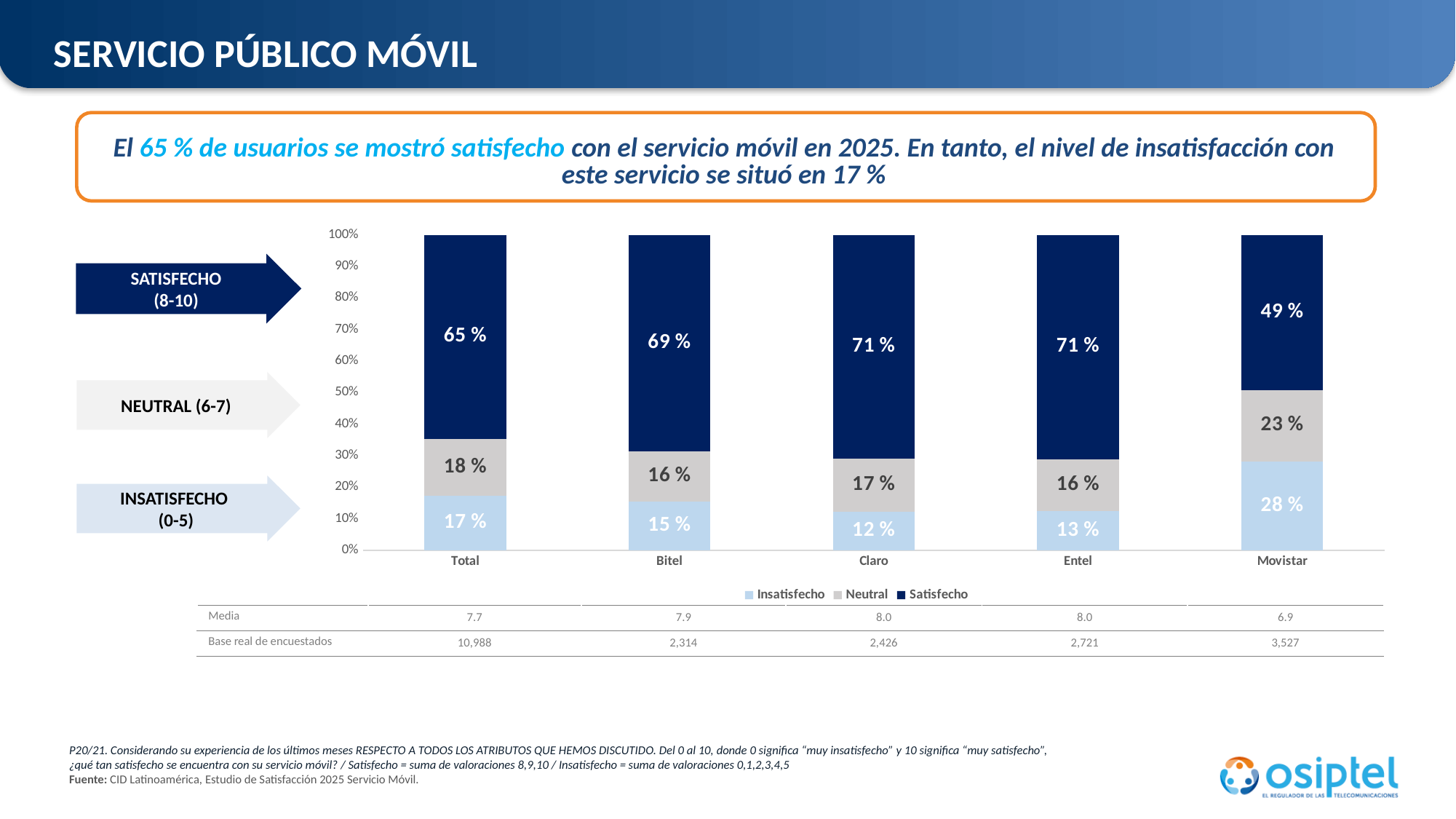
What is the Neutral value for Total? 18 % How many categories are shown on the x axis of the chart? 5 What is the difference between the Satisfecho values for Bitel and Movistar? 20 % What is the Insatisfecho value for Claro? 12 % Which series is shown in the darkest blue colour in the legend? Satisfecho Which operator has the lowest Satisfecho share? Movistar Which operator has the highest Insatisfecho share? Movistar How many series does the legend list? 3 What kind of chart is shown on the slide? Stacked bar chart What percentage of Movistar users are Satisfecho? 49 % What is the total of the stacked bar for Claro? 100 % Which is larger, the Insatisfecho value for Bitel or for Entel? Bitel